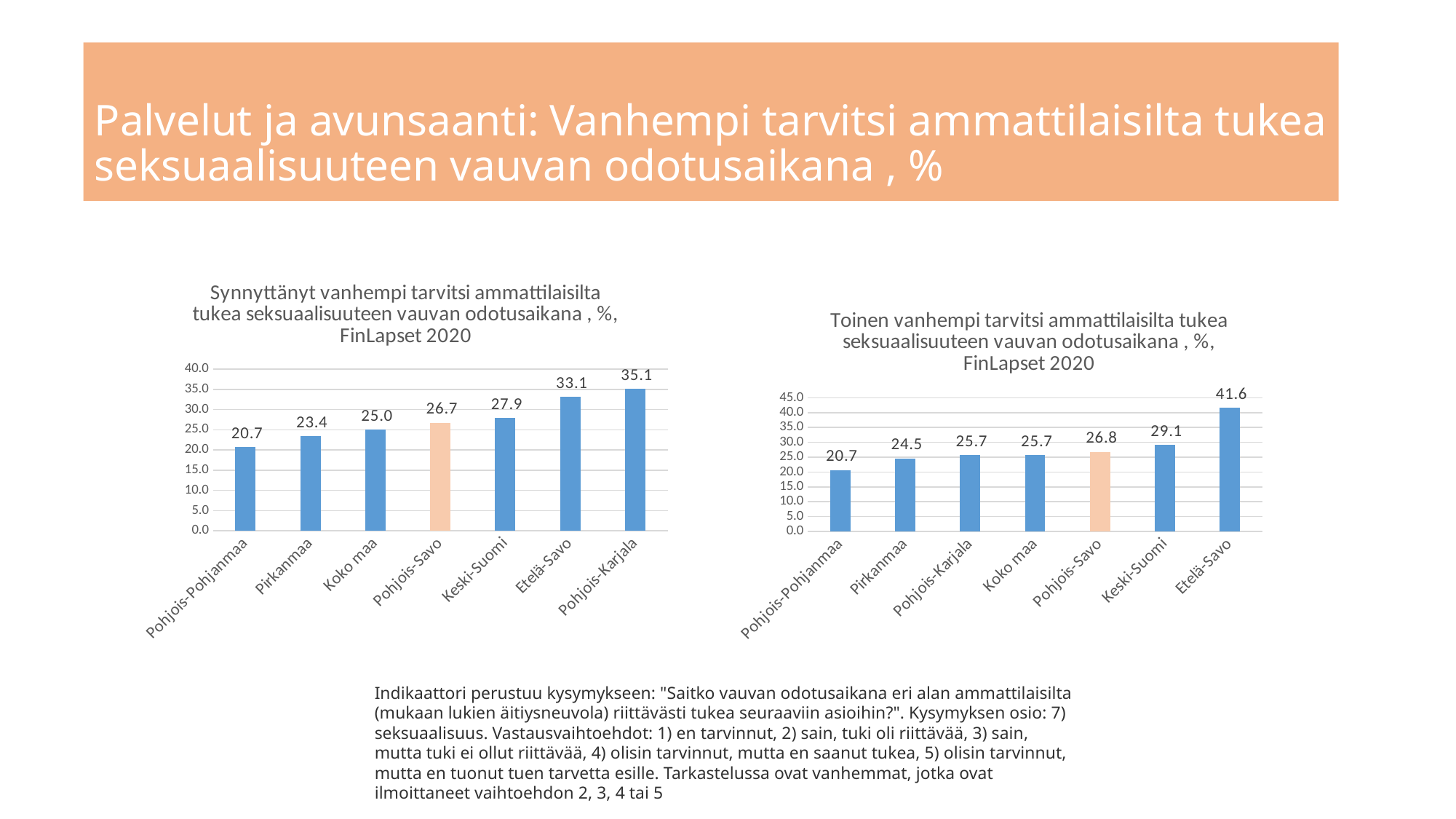
In the right chart (Toinen vanhempi), what is the value for Keski-Suomi? 29.1 In the right chart (Toinen vanhempi), what is the value for Etelä-Savo? 41.6 In the left chart (Synnyttänyt vanhempi), what is the difference between Pohjois-Karjala and Koko maa? 10.1 In the right chart (Toinen vanhempi), which region has the highest value? Etelä-Savo In the right chart (Toinen vanhempi), which is larger, the value for Pirkanmaa or the value for Pohjois-Savo? Pohjois-Savo In the right chart (Toinen vanhempi), do the values rise or fall from left to right along the x axis? Rise In the left chart (Synnyttänyt vanhempi), how many regions are shown on the x axis? 7 In the left chart (Synnyttänyt vanhempi), what is the value for Pohjois-Savo? 26.7 In the right chart (Toinen vanhempi), what is the difference between Etelä-Savo and Pohjois-Pohjanmaa? 20.9 In the left chart (Synnyttänyt vanhempi), which region has the lowest value? Pohjois-Pohjanmaa In the left chart (Synnyttänyt vanhempi), which region has the highest value? Pohjois-Karjala What type of chart is the left chart (Synnyttänyt vanhempi)? Bar chart